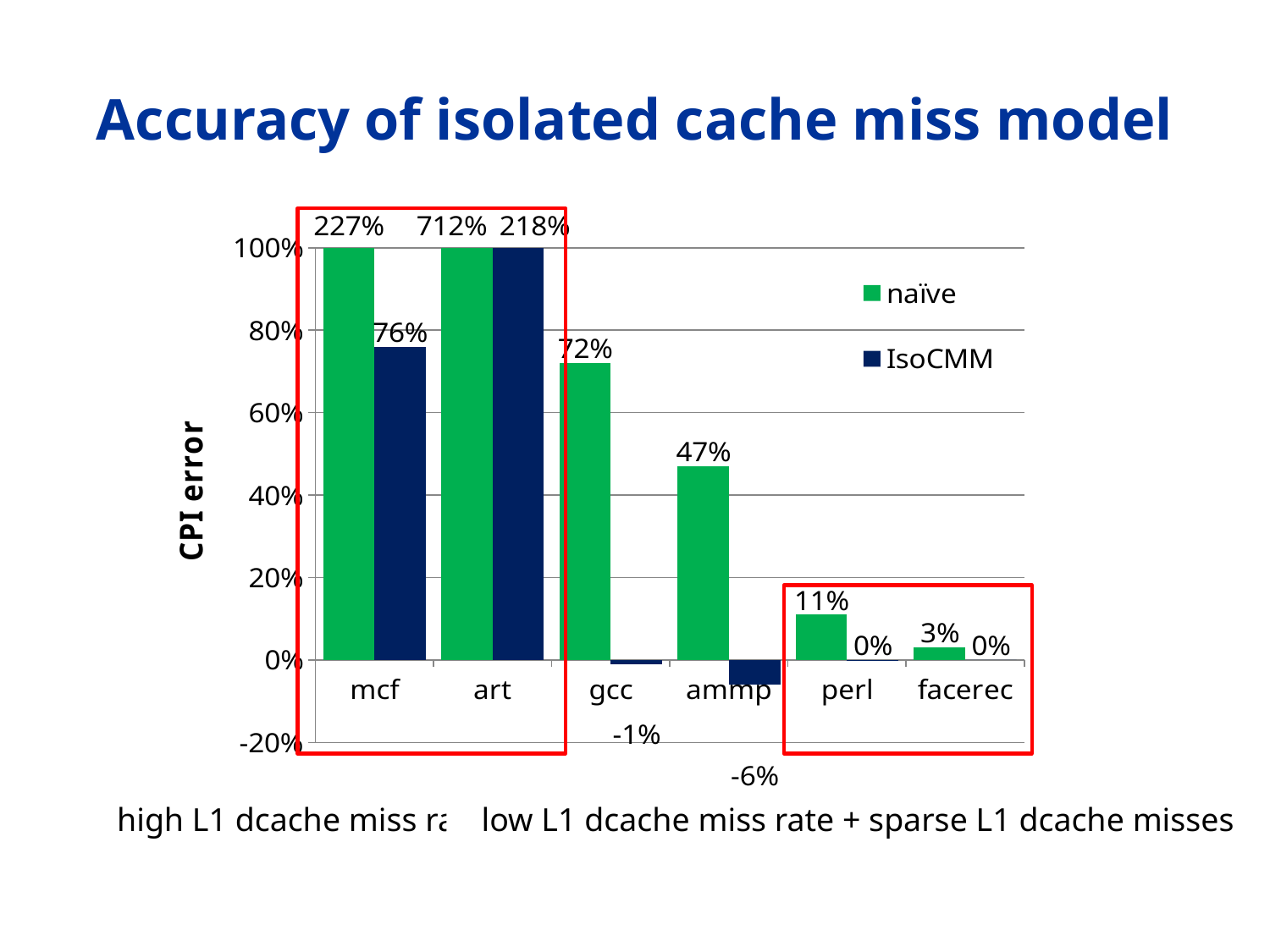
How many series does the legend list? 2 Which benchmark has the highest naïve CPI error? art What is the IsoCMM CPI error for art? 218% What kind of chart is shown on the slide? bar chart What is the naïve CPI error for mcf? 227% How many benchmarks are shown on the x axis? 6 What is the IsoCMM CPI error for ammp? -6% Which benchmark has the lowest naïve CPI error? facerec What is the difference between the naïve and IsoCMM CPI error for mcf? 151 percentage points Which is larger for gcc, the naïve CPI error or the IsoCMM CPI error? naïve What is the naïve CPI error for perl? 11%